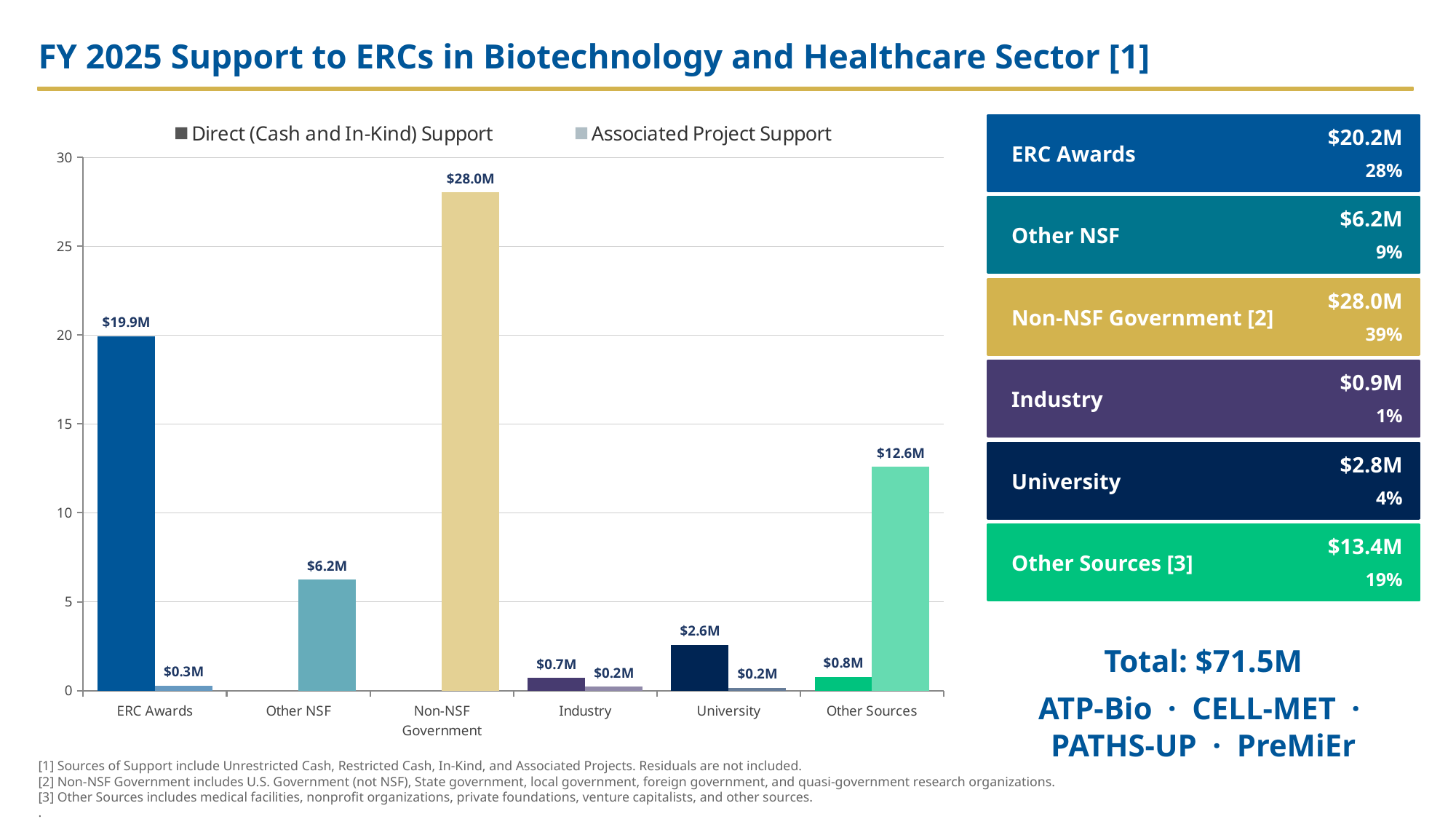
Is the Direct (Cash and In-Kind) Support for ERC Awards greater or less than 15? greater What is the Direct (Cash and In-Kind) Support value for University? $2.6M What is the Direct (Cash and In-Kind) Support value for ERC Awards? $19.9M How many series does the chart legend list? 2 What is the Associated Project Support value for Industry? $0.2M Which category has the highest Direct (Cash and In-Kind) Support? ERC Awards What is the Associated Project Support value for Other Sources? $12.6M Which is larger: the Associated Project Support for Other NSF or for Other Sources? Other Sources What kind of chart is shown on the slide? Bar chart How many categories are shown on the x axis of the chart? 6 Which category has the lowest Direct (Cash and In-Kind) Support? Industry